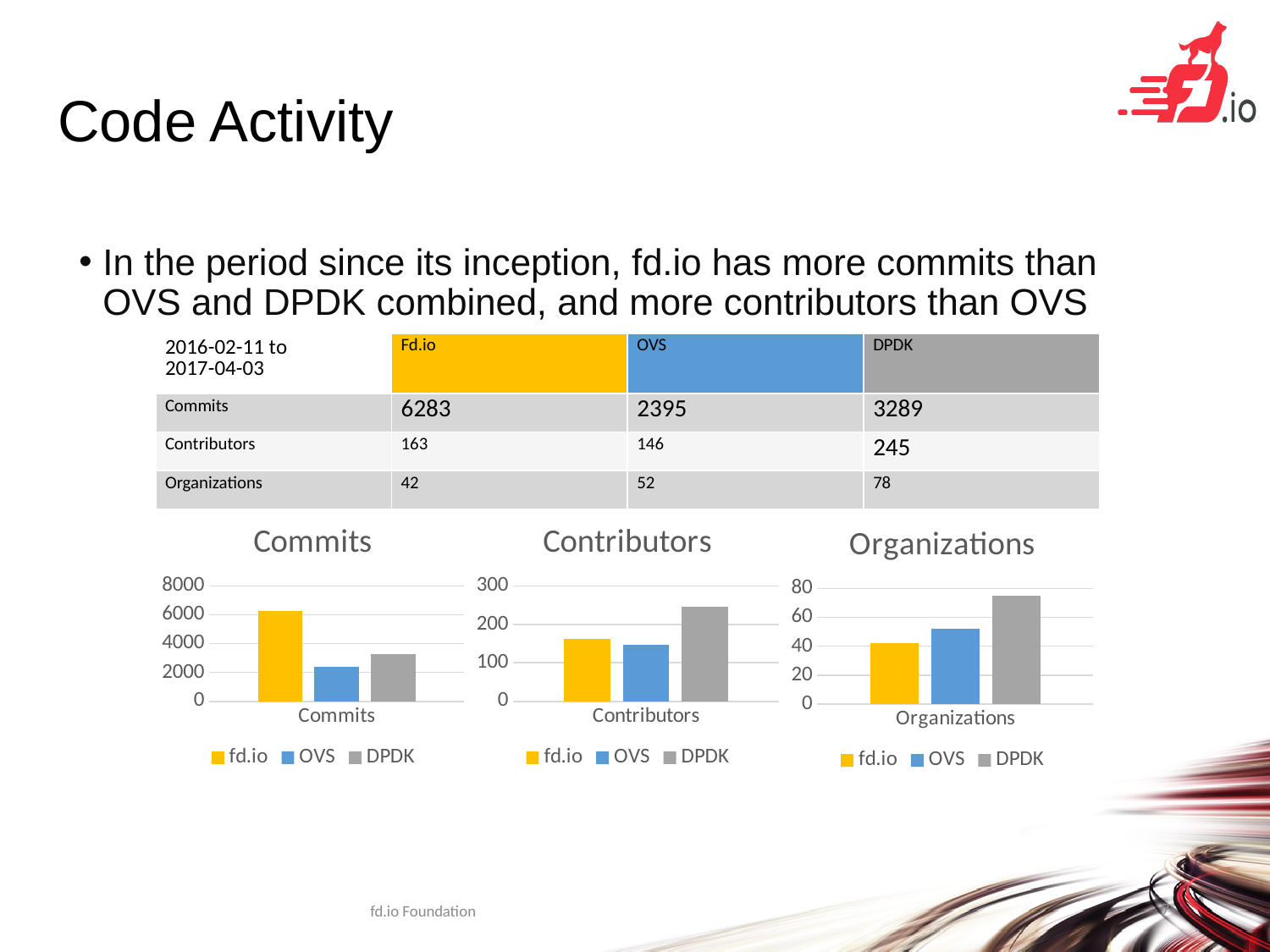
In the Commits chart, what is the value for fd.io? 6283 In the Organizations chart, what is the value for OVS? 52 What kind of chart is the Organizations chart? bar chart In the Contributors chart, what is the value for DPDK? 245 How many series does the legend of the Contributors chart list? 3 In the Commits chart, what is the difference between the fd.io and OVS values? 3888 In the Contributors chart, is the value for fd.io greater or less than 200? less In the Organizations chart, which series has the highest value? DPDK In the Commits chart, which series has the highest value? fd.io In the Organizations chart, is the value for DPDK greater or less than 60? greater In the Contributors chart, which series has the lowest value? OVS In the Commits chart, which is larger, the value for OVS or the value for DPDK? DPDK